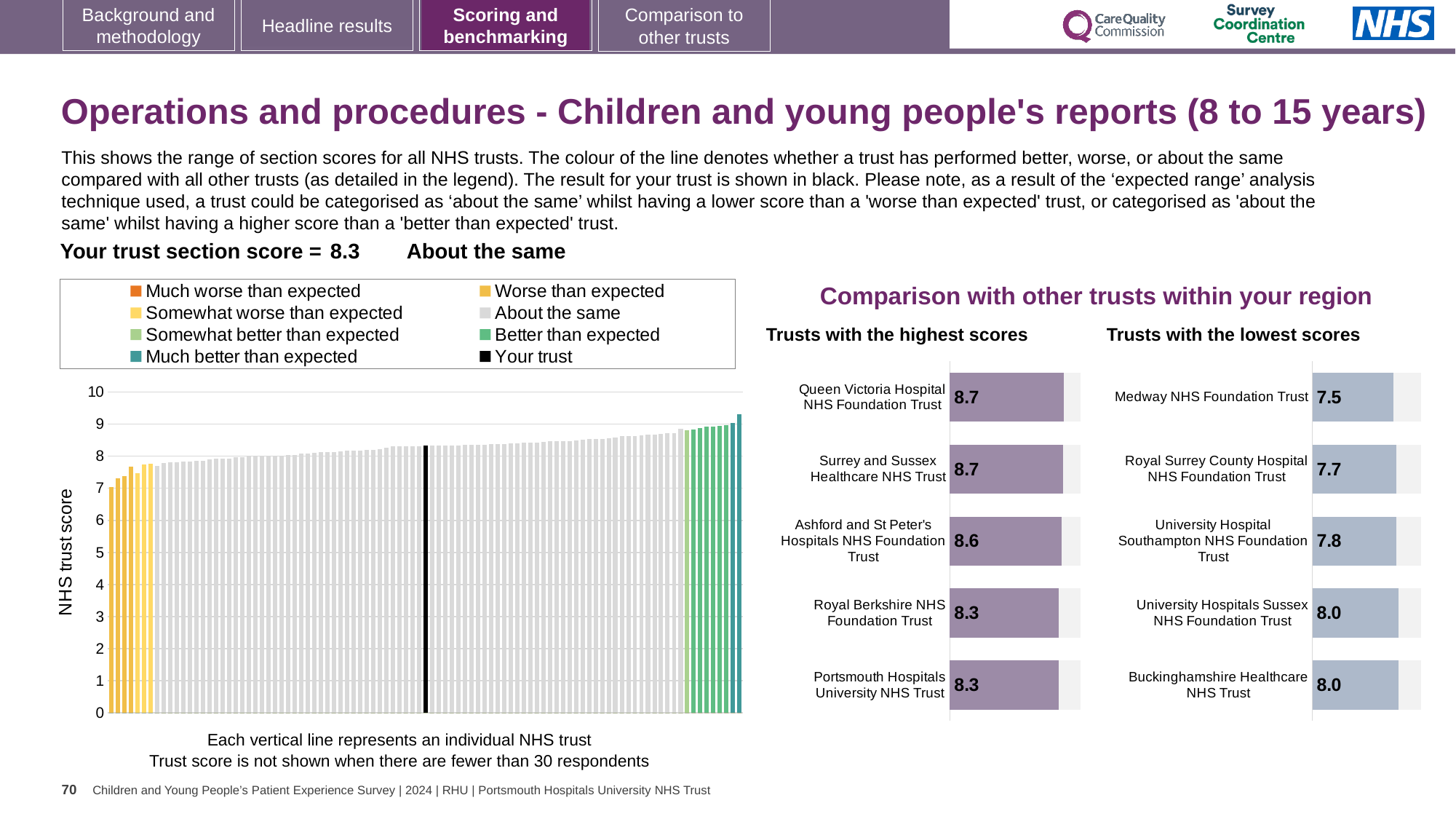
In the large chart on the left, is the value for the black 'Your trust' bar greater or less than 8? greater In the 'Trusts with the highest scores' chart, how many trusts are listed? 5 In the 'Trusts with the lowest scores' chart, what is the difference between the scores of Buckinghamshire Healthcare NHS Trust and Medway NHS Foundation Trust? 0.5 In the 'Trusts with the highest scores' chart, what is the score for Ashford and St Peter's Hospitals NHS Foundation Trust? 8.6 In the 'Trusts with the lowest scores' chart, what is the score for Medway NHS Foundation Trust? 7.5 In the large chart on the left, do the NHS trust scores rise or fall from left to right? Rise In the 'Trusts with the lowest scores' chart, which has the higher score: Royal Surrey County Hospital NHS Foundation Trust or University Hospital Southampton NHS Foundation Trust? University Hospital Southampton NHS Foundation Trust In the 'Trusts with the highest scores' chart, what is the difference between the scores of Queen Victoria Hospital NHS Foundation Trust and Portsmouth Hospitals University NHS Trust? 0.4 What kind of chart is the large chart on the left showing NHS trust scores? Bar chart How many entries does the legend above the large chart on the left list? 8 In the 'Trusts with the highest scores' chart, what is the score for Queen Victoria Hospital NHS Foundation Trust? 8.7 In the 'Trusts with the lowest scores' chart, which trust has the lowest score? Medway NHS Foundation Trust